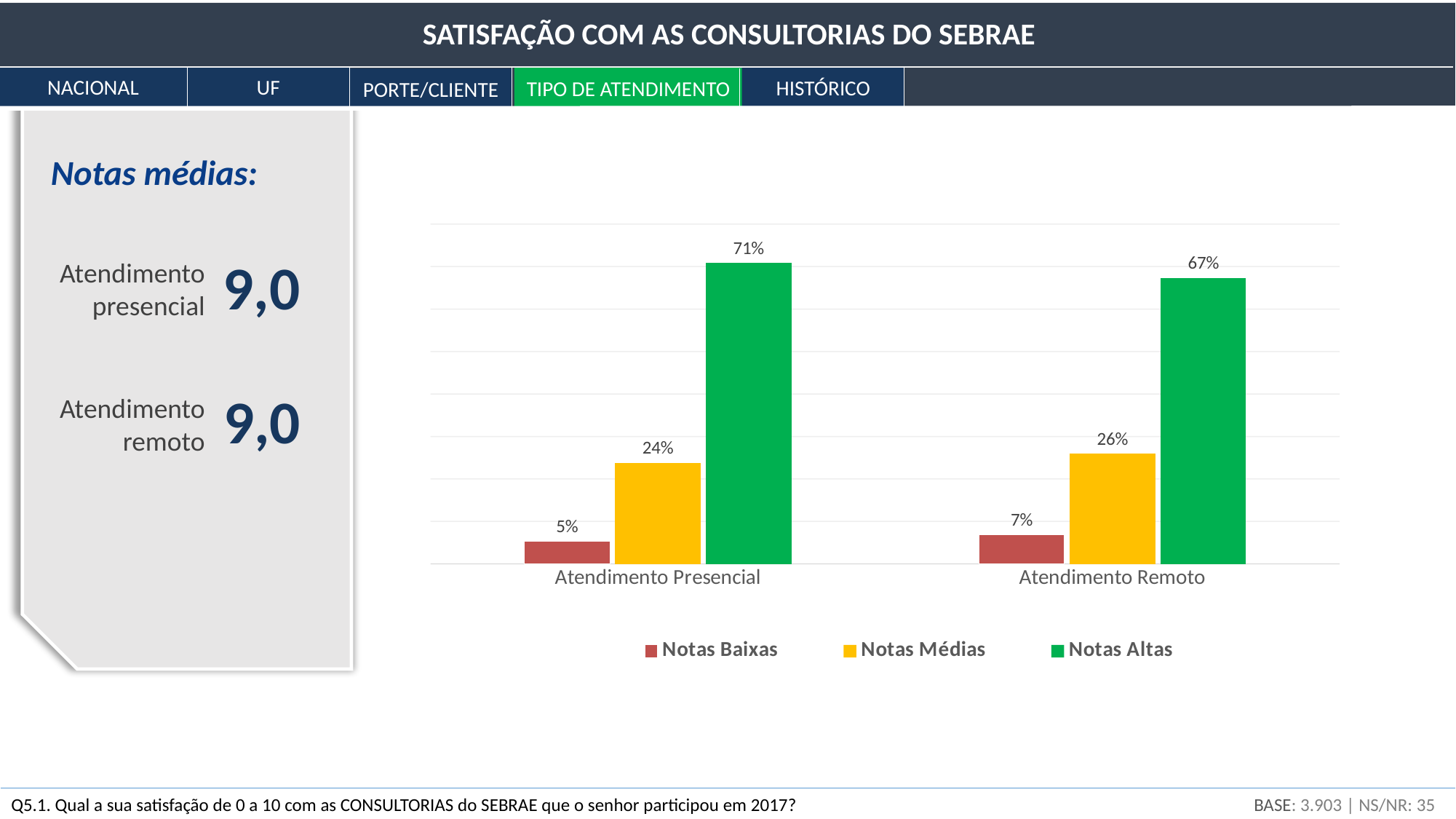
What is the value of Notas Médias for Atendimento Presencial? 24% What colour represents Notas Altas in the chart? Green Which is larger: Notas Médias for Atendimento Remoto or Notas Médias for Atendimento Presencial? Atendimento Remoto What is the value of Notas Altas for Atendimento Presencial? 71% Which category has the higher value for Notas Altas? Atendimento Presencial What kind of chart is shown on the slide? Bar chart What is the difference between Notas Altas for Atendimento Presencial and Atendimento Remoto? 4% What is the value of Notas Baixas for Atendimento Remoto? 7% How many categories are shown on the x axis of the chart? 2 Which series has the lowest value for Atendimento Presencial? Notas Baixas What is the value of Notas Altas for Atendimento Remoto? 67% How many series does the chart legend list? 3